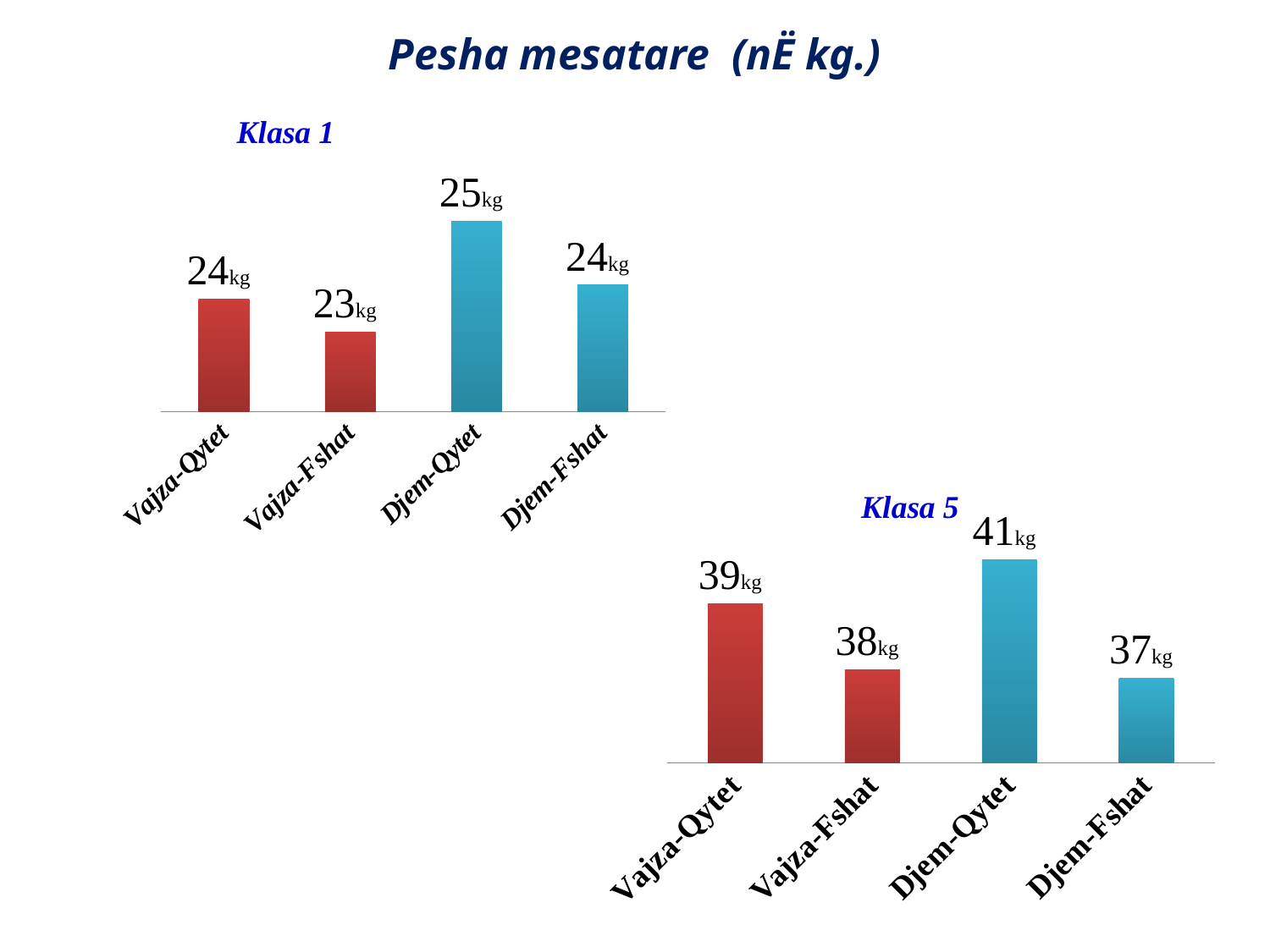
In the Klasa 5 chart, what is the difference between Djem-Qytet and Djem-Fshat? 4kg In the Klasa 5 chart, what is the value for Vajza-Qytet? 39kg How many categories does the Klasa 5 chart show? 4 In the Klasa 1 chart, which category has the lowest value? Vajza-Fshat In the Klasa 1 chart, which category has the highest value? Djem-Qytet In the Klasa 1 chart, what is the value for Vajza-Fshat? 23kg What kind of chart is the Klasa 1 chart? Bar chart In the Klasa 1 chart, what is the value for Djem-Qytet? 25kg In the Klasa 1 chart, which is larger, Vajza-Qytet or Vajza-Fshat? Vajza-Qytet In the Klasa 5 chart, what is the value for Djem-Fshat? 37kg In the Klasa 5 chart, which category has the lowest value? Djem-Fshat In the Klasa 5 chart, which category has the highest value? Djem-Qytet